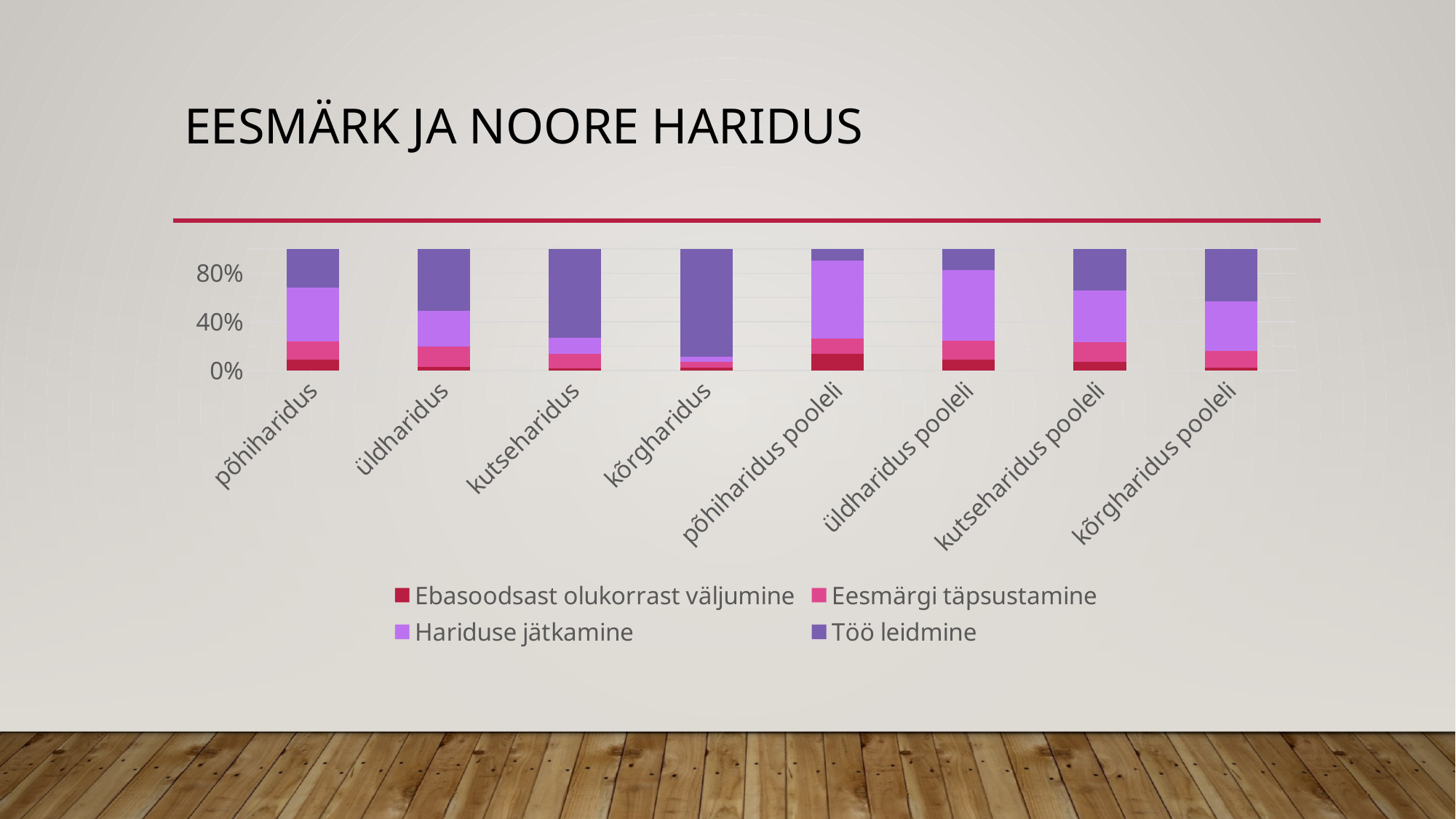
What is the title of the slide containing the chart? Eesmärk ja noore haridus Which category has the smallest Hariduse jätkamine share? kõrgharidus Is the Töö leidmine share for põhiharidus pooleli greater or less than 40%? less How many education categories are shown on the x axis? 8 Which category has the largest Töö leidmine share? kõrgharidus Which legend entry is shown in the darkest purple colour? Töö leidmine Is the Töö leidmine share for kõrgharidus greater or less than 80%? greater Is the Hariduse jätkamine share for põhiharidus pooleli greater or less than 40%? greater How many series does the legend list? 4 What kind of chart is shown on the slide? Stacked bar chart Which has the larger Töö leidmine share, kõrgharidus or põhiharidus pooleli? kõrgharidus